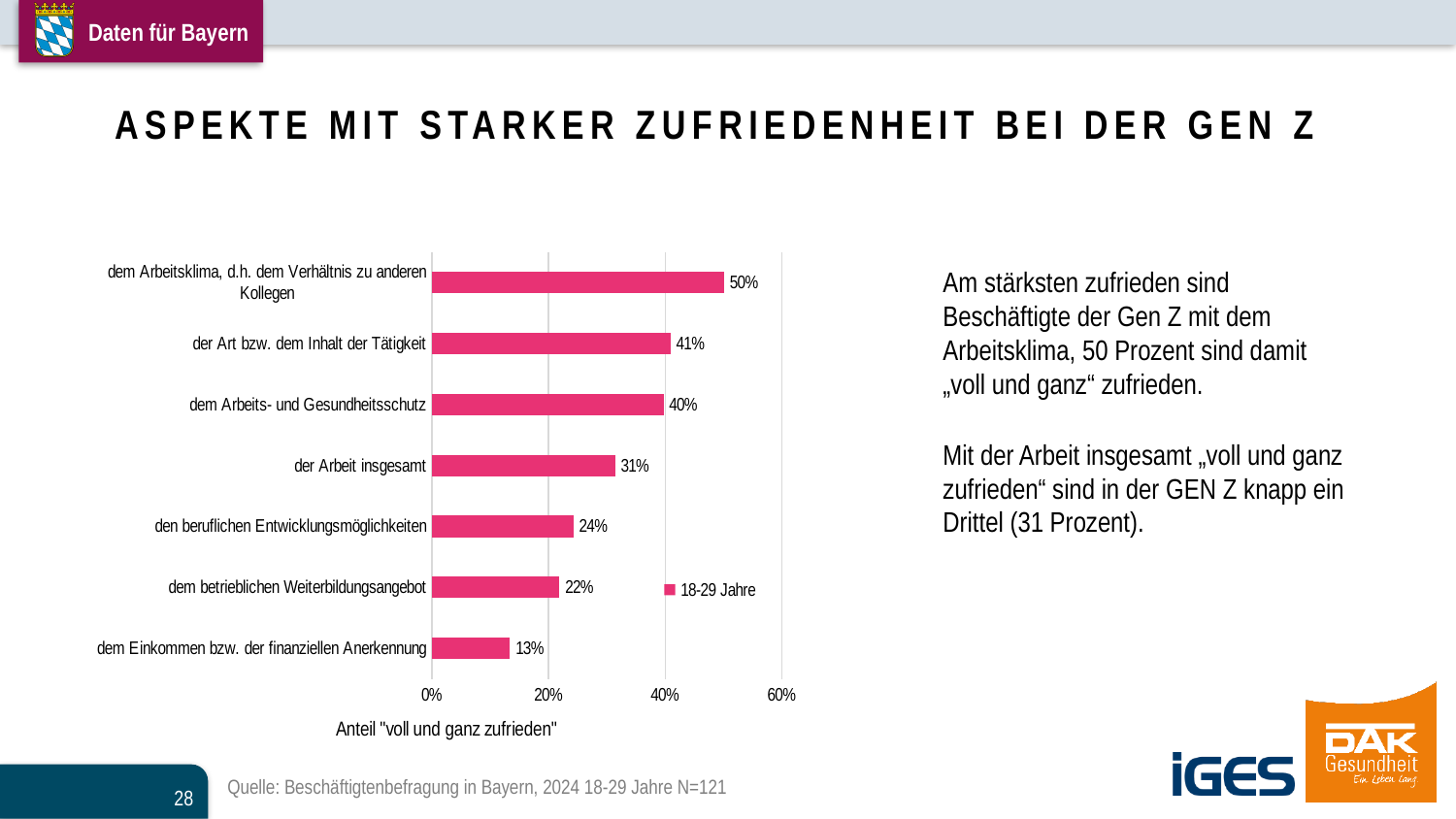
What is the value for "dem Einkommen bzw. der finanziellen Anerkennung"? 13% Is the value for "der Arbeit insgesamt" greater or less than 40%? less Which category has the highest value? dem Arbeitsklima, d.h. dem Verhältnis zu anderen Kollegen How many series does the legend list? 1 Which category has the lowest value? dem Einkommen bzw. der finanziellen Anerkennung What is the value for "der Arbeit insgesamt"? 31% Which is larger: the value for "den beruflichen Entwicklungsmöglichkeiten" or for "dem betrieblichen Weiterbildungsangebot"? den beruflichen Entwicklungsmöglichkeiten What kind of chart is shown on the slide? bar chart How many categories are shown in the chart? 7 What is the difference between the values for "der Art bzw. dem Inhalt der Tätigkeit" and "den beruflichen Entwicklungsmöglichkeiten"? 17% What is the value for "dem Arbeits- und Gesundheitsschutz"? 40% What is the label of the series in the legend? 18-29 Jahre